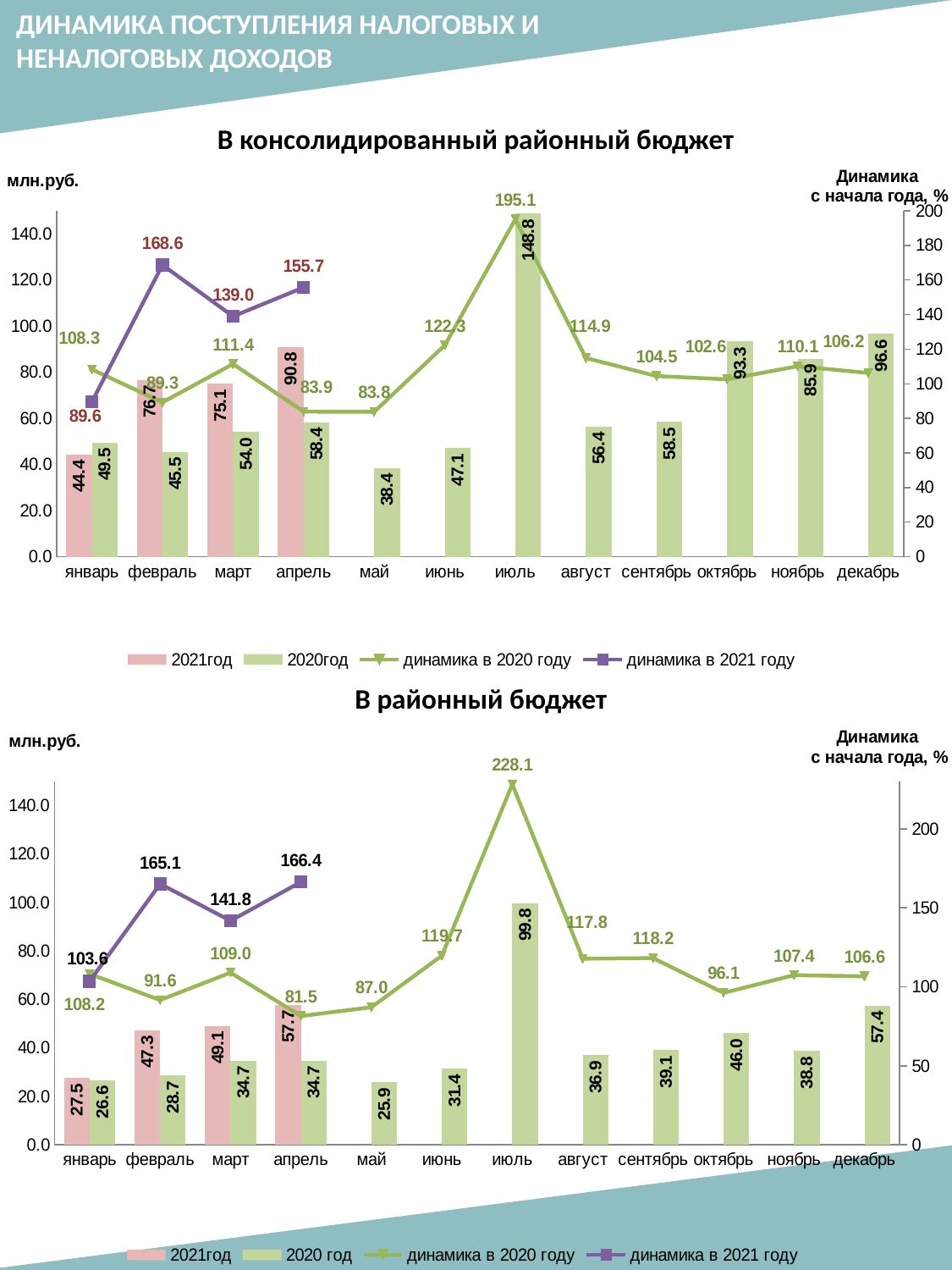
In the chart 'В консолидированный районный бюджет', what is the difference between the 2021год and 2020год bars for февраль? 31.2 In the chart 'В консолидированный районный бюджет', what is the value of the 2020год bar for июль? 148.8 In the chart 'В районный бюджет', what is the value of the 2020 год bar for декабрь? 57.4 In the chart 'В консолидированный районный бюджет', how many series does the legend list? 4 In the chart 'В районный бюджет', how many months are shown on the x axis? 12 In the chart 'В районный бюджет', what is the difference between the 'динамика в 2020 году' values for июль and август? 110.3 In the chart 'В районный бюджет', what is the value of the 'динамика в 2021 году' line for апрель? 166.4 In the chart 'В консолидированный районный бюджет', which month has the highest value on the 'динамика в 2020 году' line? июль In the chart 'В районный бюджет', which is larger for март: the 2021год bar or the 2020 год bar? 2021год What kind of chart is 'В районный бюджет'? Combined bar and line chart In the chart 'В консолидированный районный бюджет', which month has the lowest 2020год bar? май In the chart 'В консолидированный районный бюджет', what is the value of the 2021год bar for апрель? 90.8